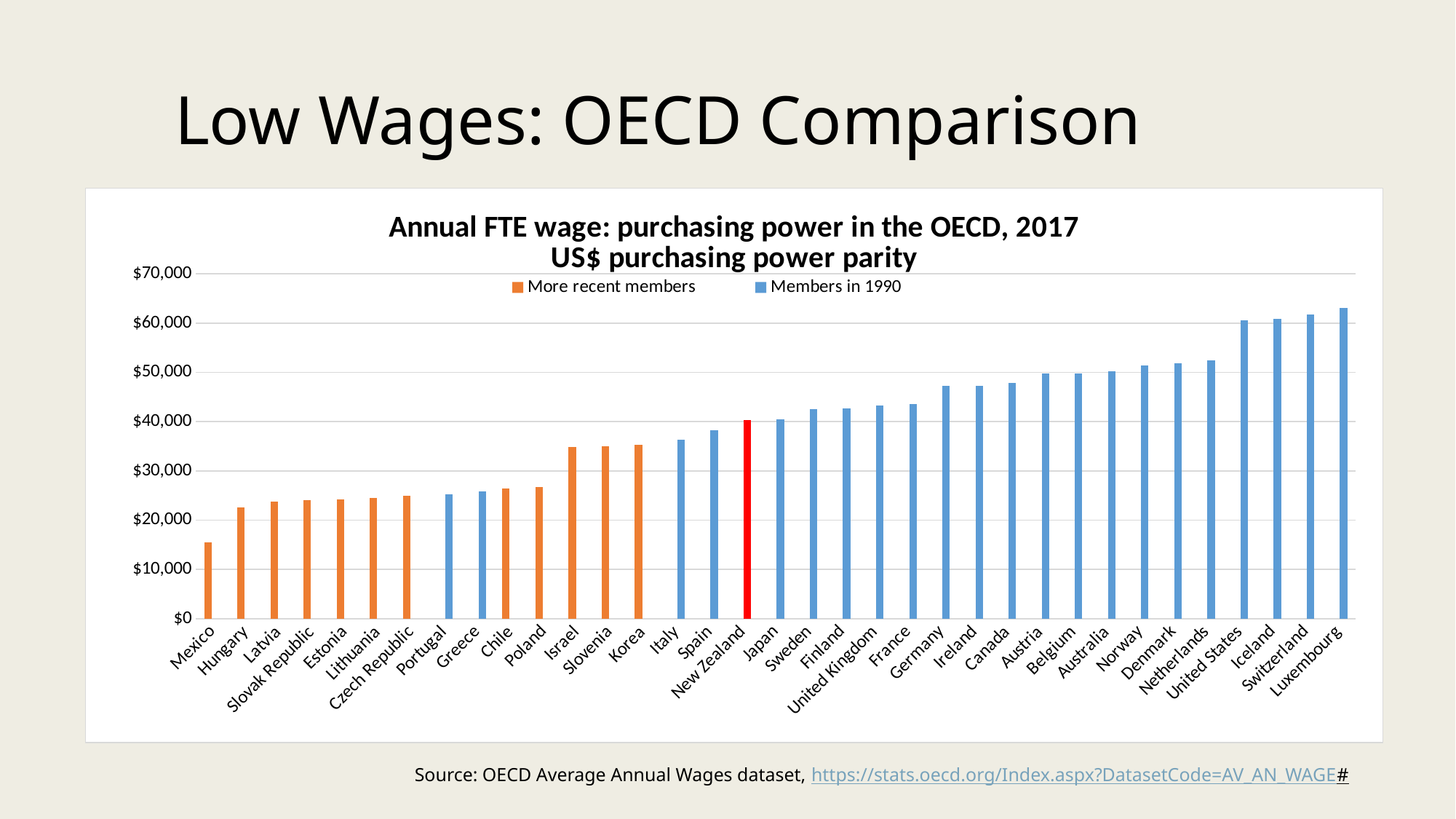
Is the value for Germany greater or less than $50,000? less Is the value for Korea greater or less than $30,000? greater How many series does the chart's legend list? 2 Is the value for Luxembourg greater or less than $60,000? greater What are the two legend entries in the chart? More recent members; Members in 1990 What kind of chart is shown on the slide? Bar chart How many countries are shown on the x axis of the chart? 35 Do the values rise or fall moving from left to right along the x axis? Rise Which has the larger value, Hungary or Mexico? Hungary Which country has the highest annual FTE wage in the chart? Luxembourg Which country has the lowest annual FTE wage in the chart? Mexico